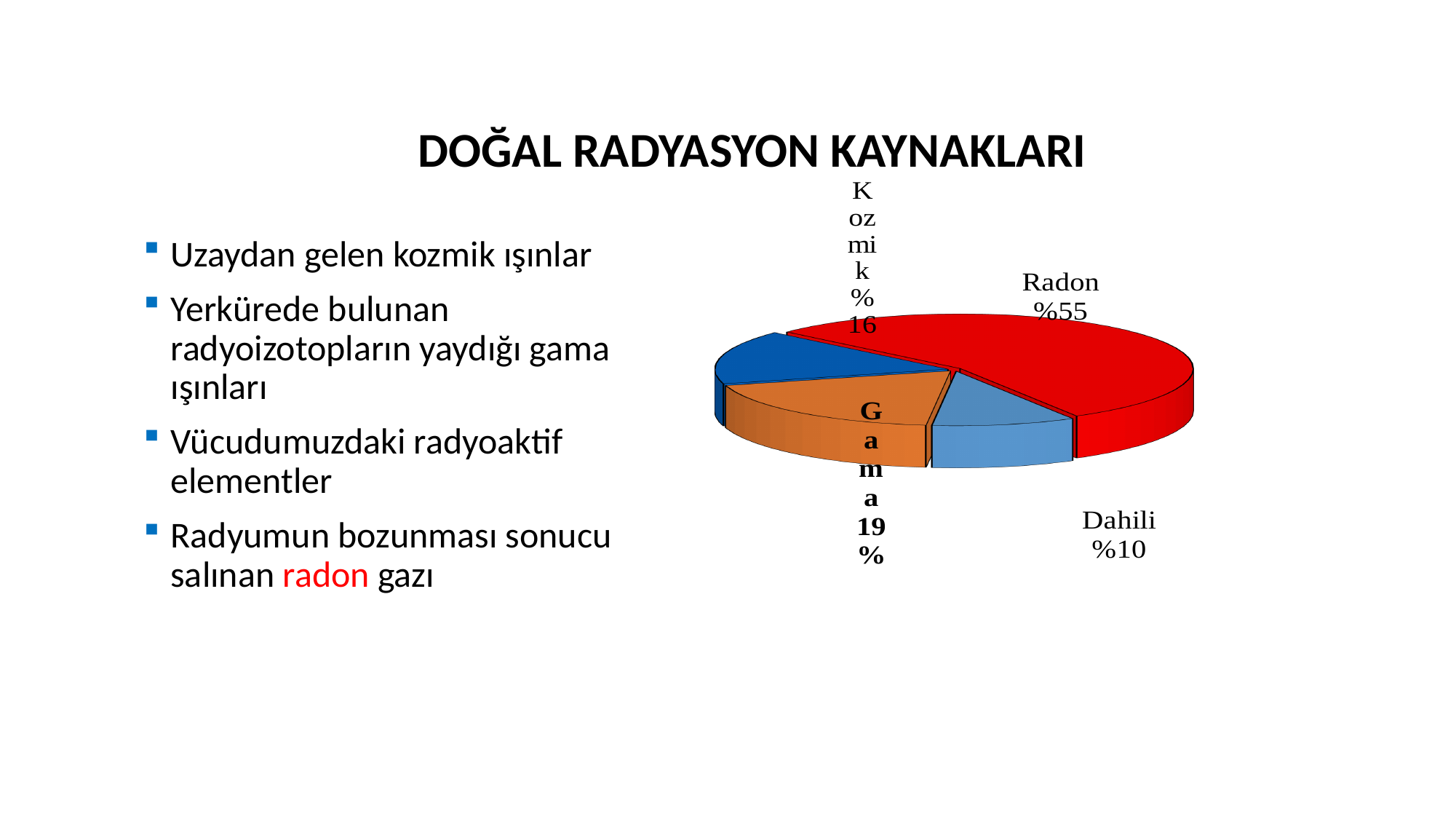
By how many percentage points does the Radon slice exceed the Dahili slice? 45 What kind of chart is shown on the slide? pie chart What value is shown for the Gama slice? 19% What value is shown for the Kozmik slice? %16 What share of the pie does the Dahili slice represent? %10 Which slice of the pie chart is the largest? Radon Which slice of the pie chart is the smallest? Dahili How many slices does the pie chart have? 4 What share of the pie does the Radon slice represent? %55 What colour is the Radon slice in the pie chart? red By how many percentage points does the Gama slice exceed the Kozmik slice? 3 Which slice is larger, Gama or Kozmik? Gama